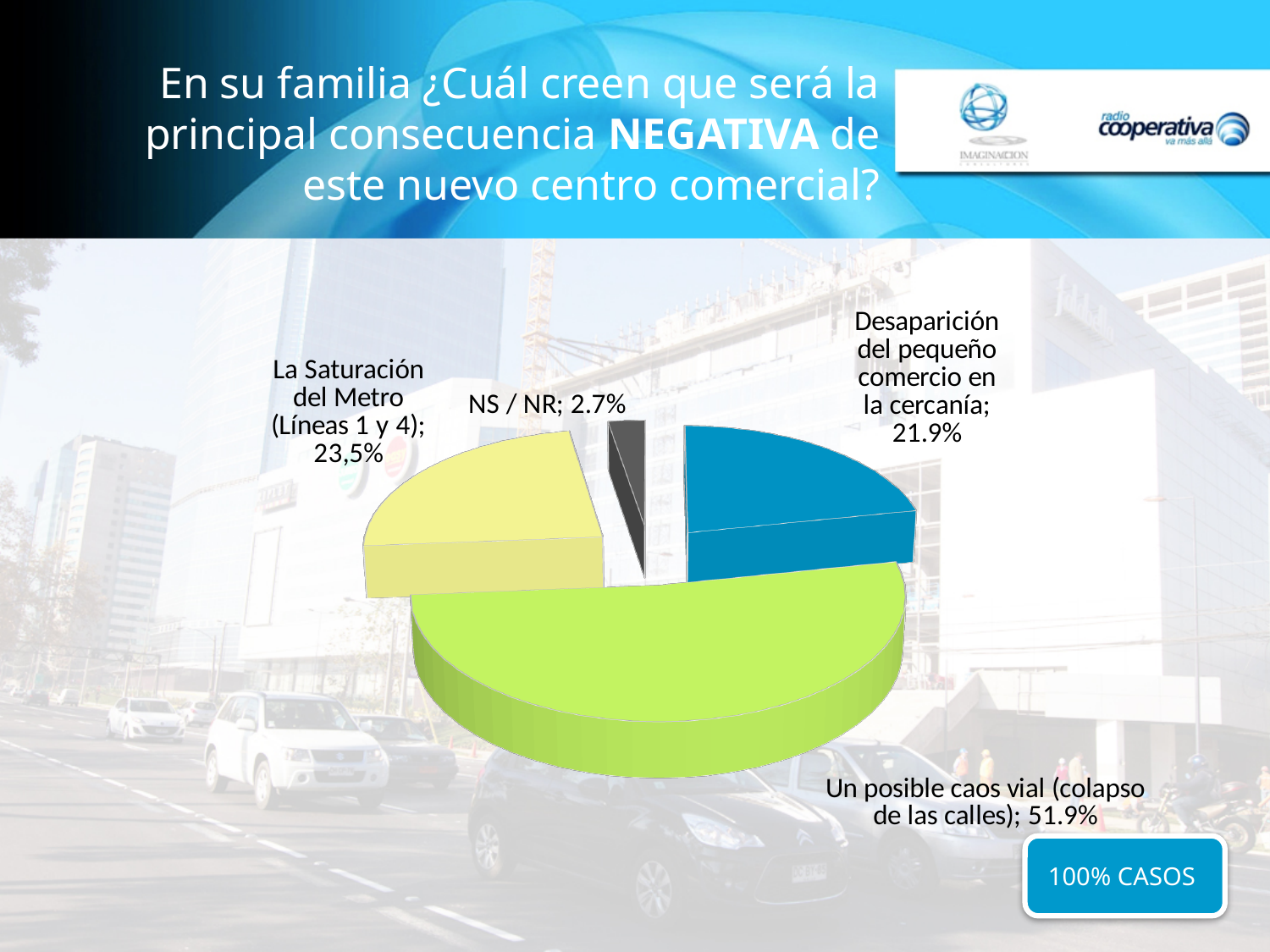
What is the value for "Desaparición del pequeño comercio en la cercanía"? 21.9% How many slices does the pie chart have? 4 Which category has the largest share of the pie? Un posible caos vial (colapso de las calles) What kind of chart is shown on the slide? Pie chart Which category has the smallest share of the pie? NS / NR What is the value for "NS / NR"? 2.7% What does the box in the bottom right corner of the slide say? 100% CASOS What is the difference between the values for "Un posible caos vial (colapso de las calles)" and "Desaparición del pequeño comercio en la cercanía"? 30.0 percentage points Which is larger, "La Saturación del Metro (Líneas 1 y 4)" or "Desaparición del pequeño comercio en la cercanía"? La Saturación del Metro (Líneas 1 y 4) What is the value for "Un posible caos vial (colapso de las calles)"? 51.9% What colour is the slice for "Un posible caos vial (colapso de las calles)"? Green What is the value for "La Saturación del Metro (Líneas 1 y 4)"? 23,5%